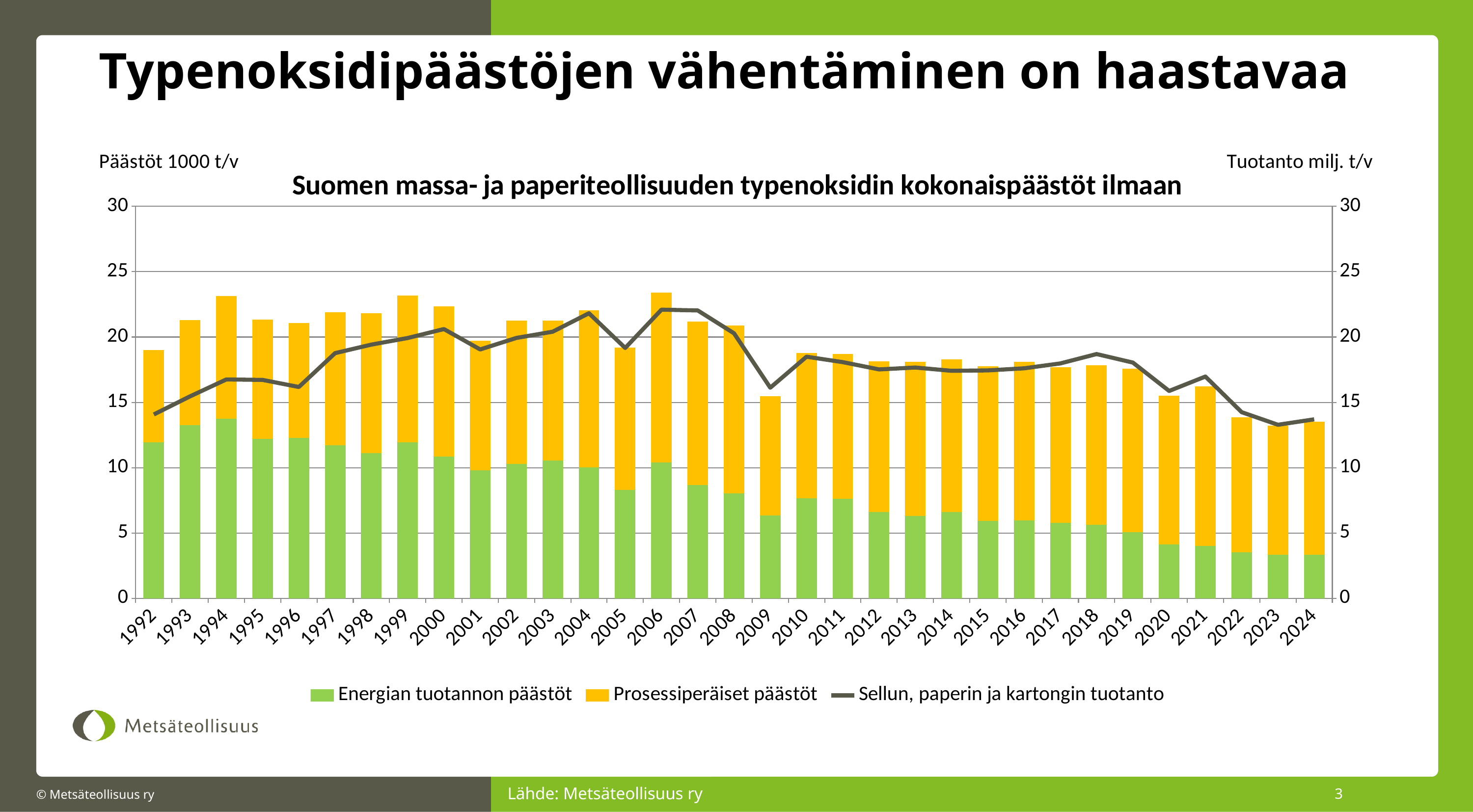
Which year has the larger value of Sellun, paperin ja kartongin tuotanto, 2006 or 2023? 2006 How many series does the legend list? 3 What kind of chart is this? Stacked bar chart with a line Is the value of Energian tuotannon päästöt for 2020 greater or less than 5? less Do the total emissions bars generally rise or fall from 1992 to 2024? fall Is the total emissions bar for 2022 greater or less than 15? less Which year has the larger total emissions bar, 1994 or 2009? 1994 How many years are shown on the x axis? 33 Is the value of Sellun, paperin ja kartongin tuotanto for 2004 greater or less than 20? greater What is the title of the chart? Suomen massa- ja paperiteollisuuden typenoksidin kokonaispäästöt ilmaan